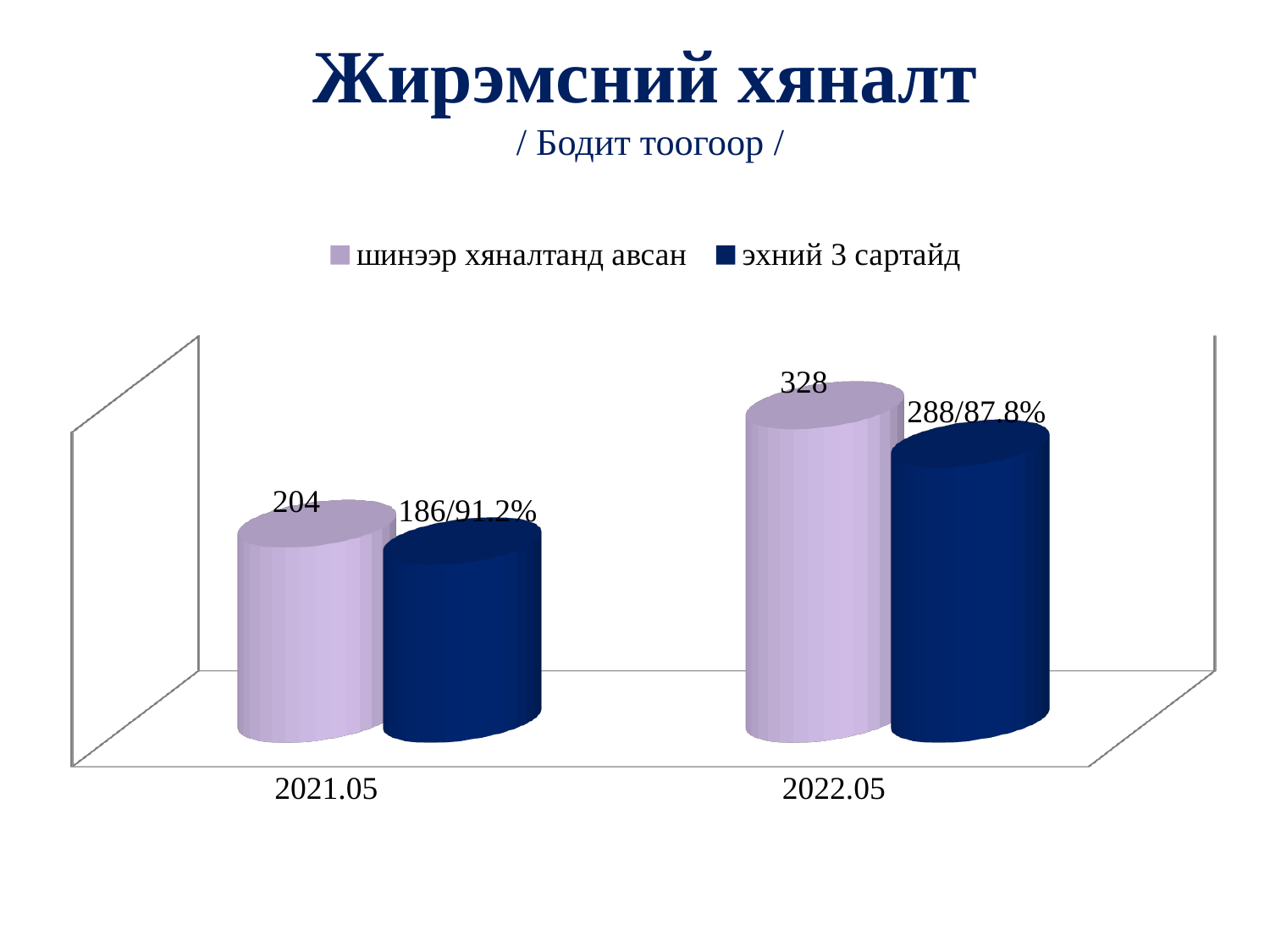
How many series does the legend list? 2 What is the value for "шинээр хяналтанд авсан" in 2021.05? 204 How many categories are shown on the x axis? 2 Which is larger in 2022.05: "шинээр хяналтанд авсан" or "эхний 3 сартайд"? шинээр хяналтанд авсан What kind of chart is shown on the slide? bar chart Does the value for "шинээр хяналтанд авсан" rise or fall from 2021.05 to 2022.05? rise In which category is the value for "эхний 3 сартайд" lowest? 2021.05 In which category is the value for "шинээр хяналтанд авсан" highest? 2022.05 What is the difference between the "шинээр хяналтанд авсан" values for 2022.05 and 2021.05? 124 What is the value for "шинээр хяналтанд авсан" in 2022.05? 328 What is the data label for "эхний 3 сартайд" in 2022.05? 288/87.8% What is the data label for "эхний 3 сартайд" in 2021.05? 186/91.2%